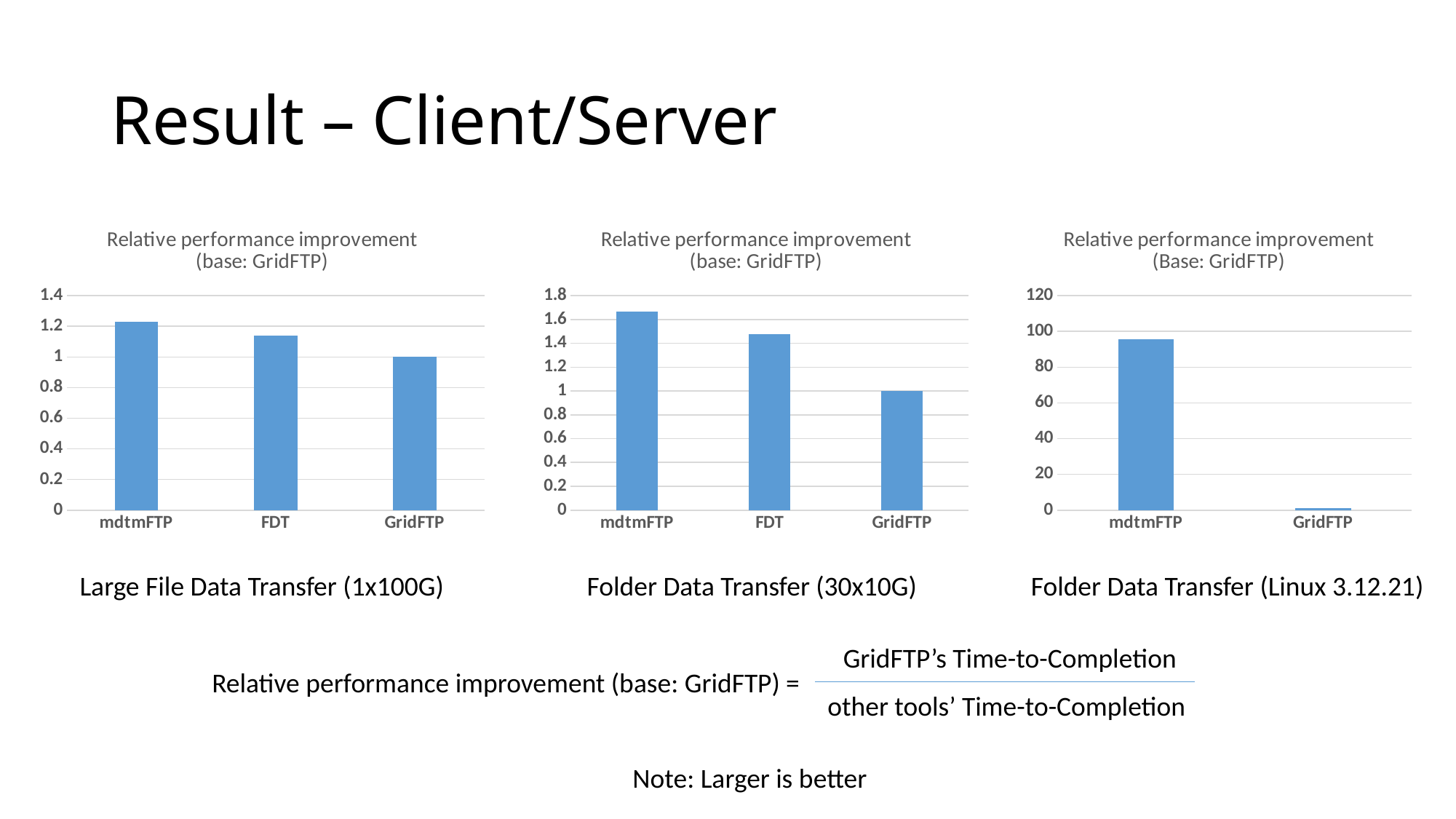
In the left chart, Large File Data Transfer (1x100G), which tool has the lowest value? GridFTP In the middle chart, Folder Data Transfer (30x10G), how many tools are shown on the x axis? 3 In the left chart, Large File Data Transfer (1x100G), is the value for mdtmFTP greater or less than 1? greater In the right chart, Folder Data Transfer (Linux 3.12.21), how many bars are there? 2 In the middle chart, Folder Data Transfer (30x10G), what is the value for GridFTP? 1 What is the title of the right chart, Folder Data Transfer (Linux 3.12.21)? Relative performance improvement (Base: GridFTP) In the right chart, Folder Data Transfer (Linux 3.12.21), is the value for mdtmFTP greater or less than 80? greater What type of chart is the left chart, Large File Data Transfer (1x100G)? bar chart In the middle chart, Folder Data Transfer (30x10G), which is larger, the value for mdtmFTP or the value for FDT? mdtmFTP In the left chart, Large File Data Transfer (1x100G), what is the value for GridFTP? 1 In the left chart, Large File Data Transfer (1x100G), which tool has the highest relative performance improvement? mdtmFTP In the middle chart, Folder Data Transfer (30x10G), is the value for FDT greater or less than 1.4? greater